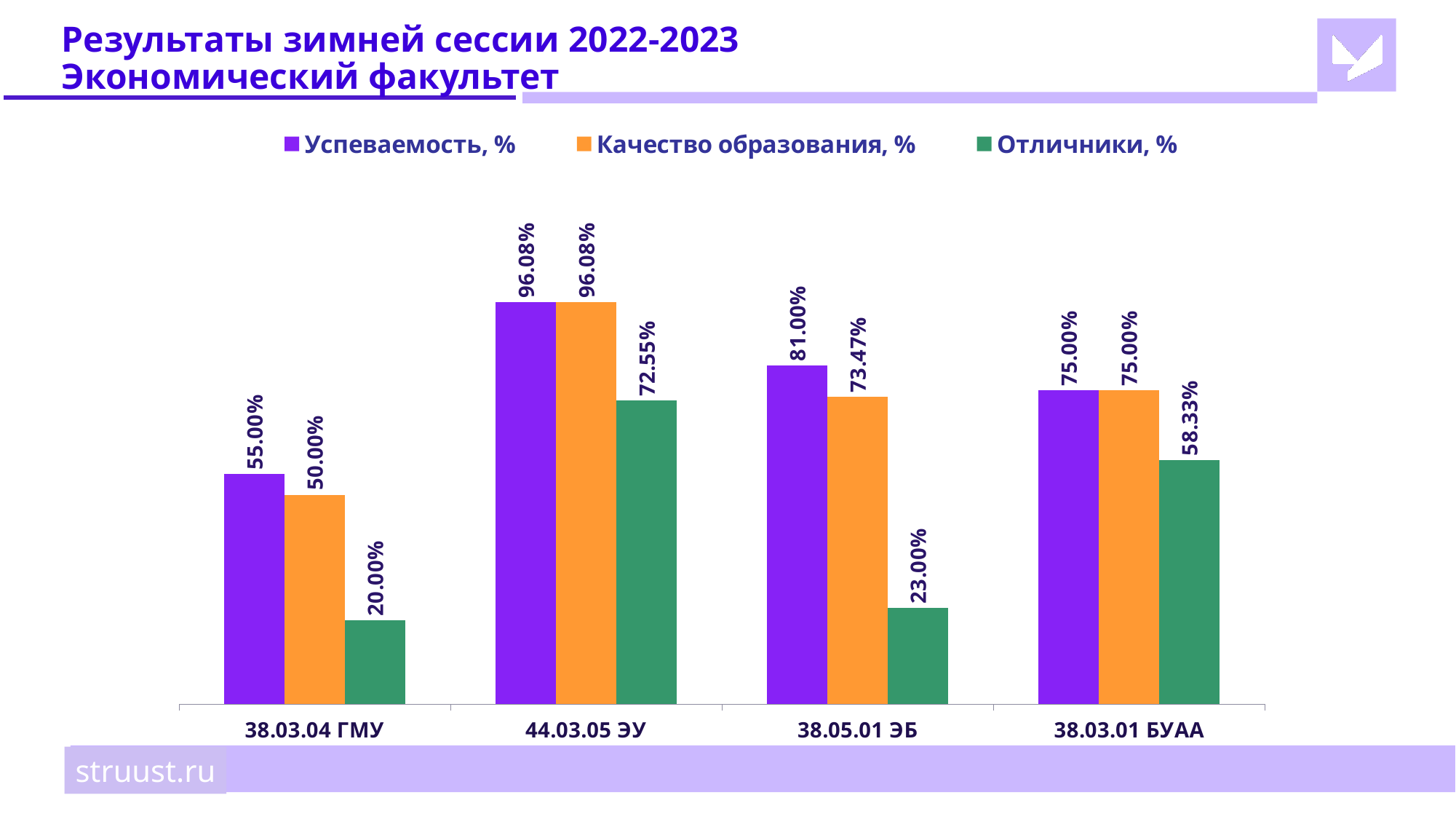
Which category has the highest value for Отличники, %? 44.03.05 ЭУ What is the value of Качество образования, % for 38.05.01 ЭБ? 73.47% How many categories are shown on the x axis? 4 Which colour represents the series Качество образования, % in the legend? Orange How many series does the legend list? 3 What is the value of Успеваемость, % for 44.03.05 ЭУ? 96.08% What kind of chart is shown on the slide? Bar chart Which category has the lowest value for Успеваемость, %? 38.03.04 ГМУ What is the value of Отличники, % for 38.03.01 БУАА? 58.33% Which is larger for 38.03.04 ГМУ: Успеваемость, % or Качество образования, %? Успеваемость, % What is the difference between Успеваемость, % and Отличники, % for 38.05.01 ЭБ? 58.00% What is the value of Отличники, % for 38.03.04 ГМУ? 20.00%